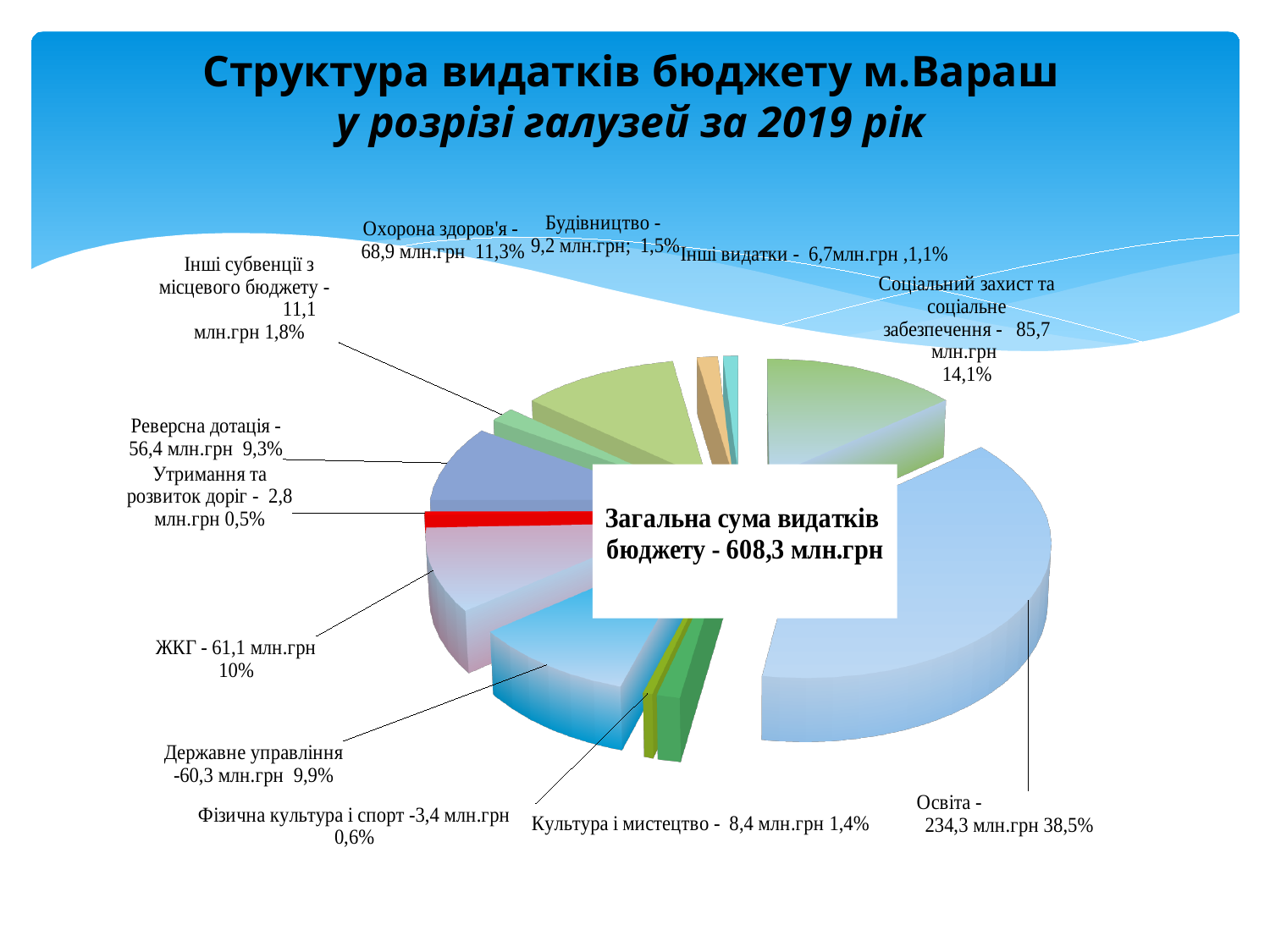
What is the value for Освіта? 234,3 млн.грн Which category has the largest slice of the pie? Освіта What share of the pie does Соціальний захист та соціальне забезпечення have? 14,1% What is the difference between the values for Освіта and Соціальний захист та соціальне забезпечення? 148,6 млн.грн What is the value for Державне управління? 60,3 млн.грн What is the value for Охорона здоров'я? 68,9 млн.грн What kind of chart is shown on the slide? pie chart What share of the pie does Культура і мистецтво have? 1,4% Which category has the smallest slice of the pie? Утримання та розвиток доріг Which is larger, ЖКГ or Реверсна дотація? ЖКГ How many categories does the pie chart show? 12 What is the total sum of budget expenditures stated on the chart? 608,3 млн.грн